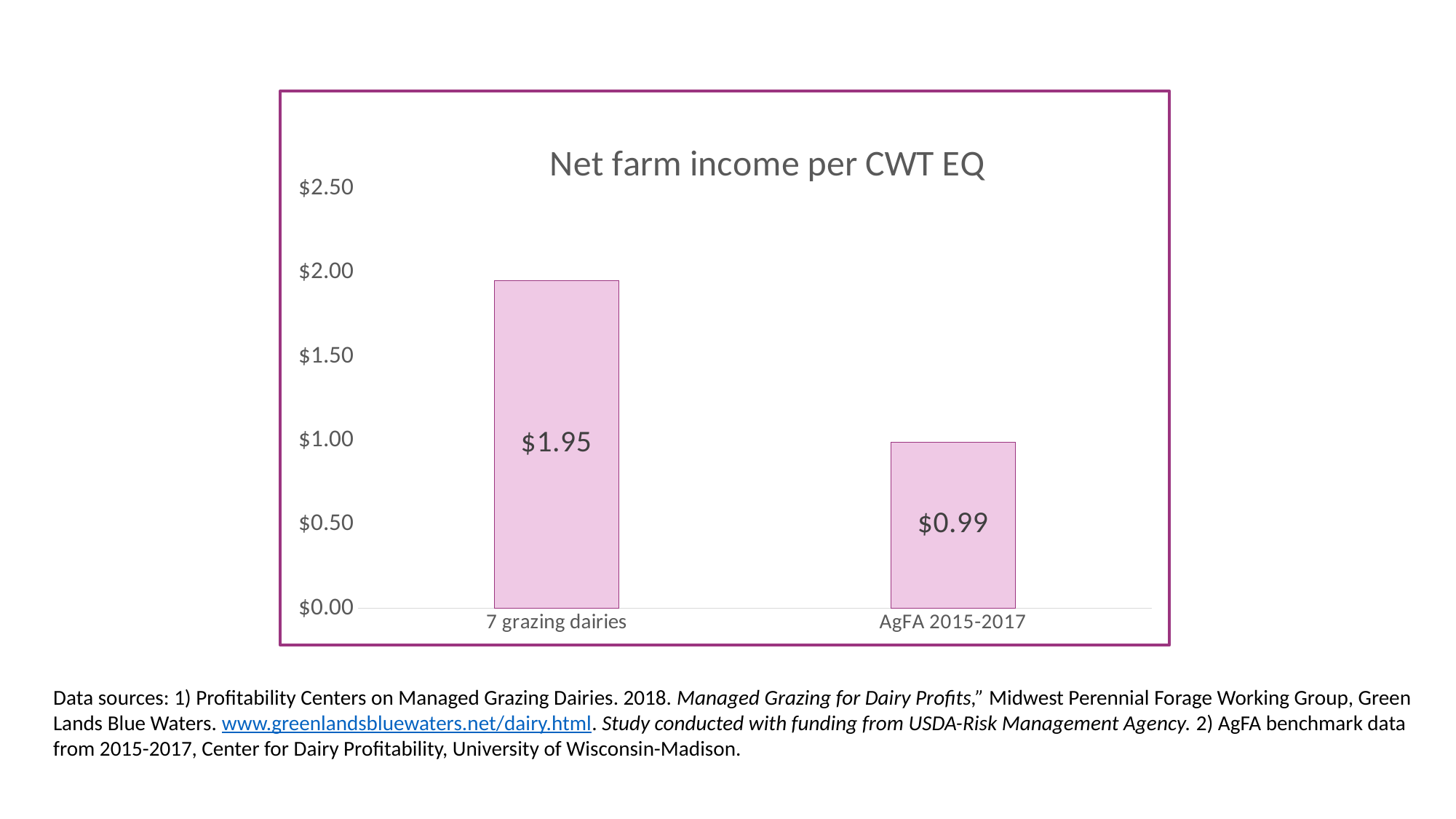
Is the value for 7 grazing dairies greater or less than $1.50? greater What is the net farm income per CWT EQ for the 7 grazing dairies? $1.95 What is the difference in net farm income per CWT EQ between the 7 grazing dairies and AgFA 2015-2017? $0.96 Is the value for AgFA 2015-2017 greater or less than $1.00? less Which category has the lowest net farm income per CWT EQ? AgFA 2015-2017 What kind of chart is shown on the slide? Bar chart Which category has the highest net farm income per CWT EQ? 7 grazing dairies What is the highest value shown on the vertical axis of the chart? $2.50 What is the net farm income per CWT EQ for AgFA 2015-2017? $0.99 How many categories are shown in the chart? 2 Which is larger, the net farm income per CWT EQ for the 7 grazing dairies or for AgFA 2015-2017? 7 grazing dairies What is the title of the chart? Net farm income per CWT EQ